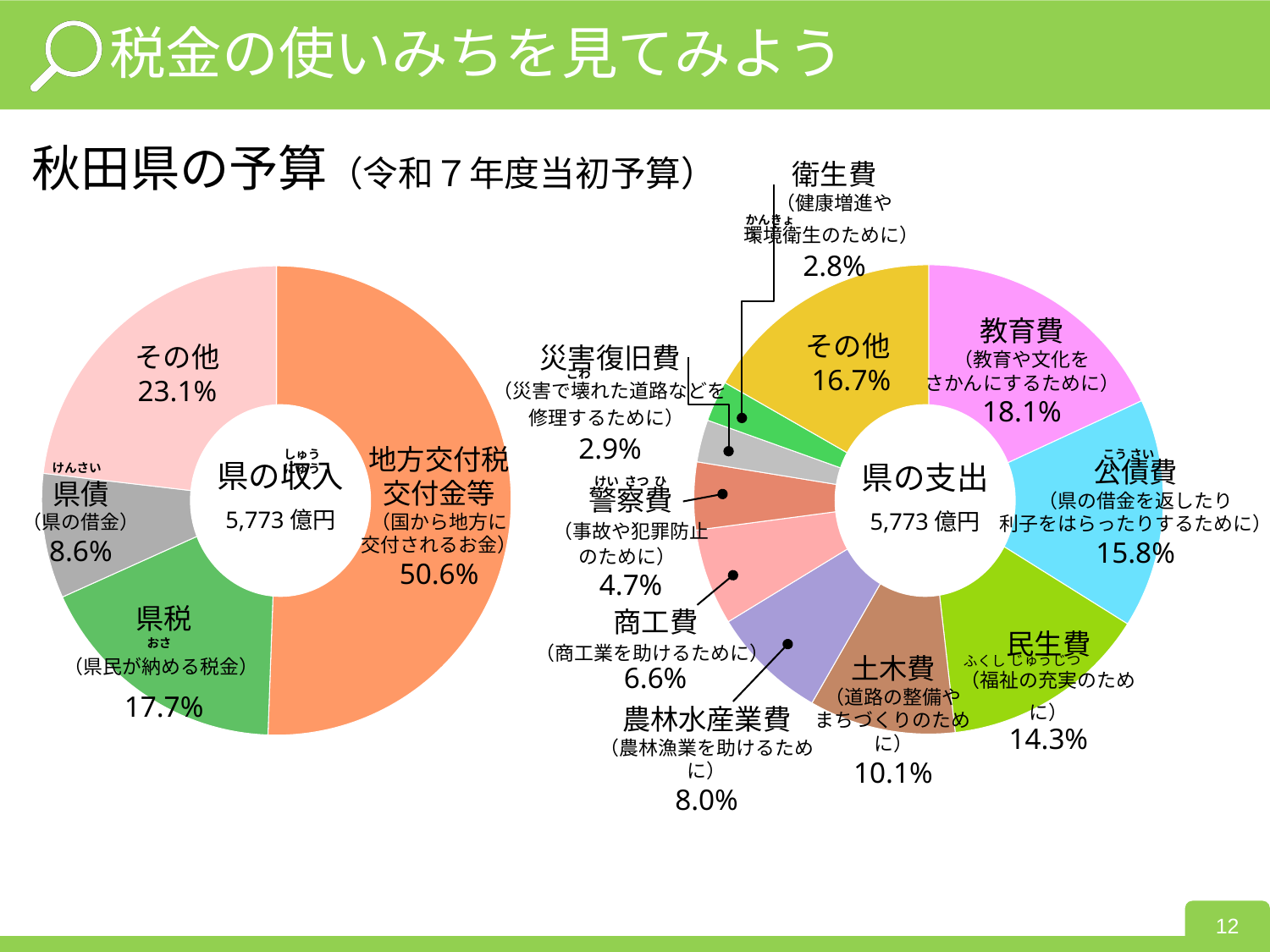
「県の収入」のグラフで、地方交付税交付金等の割合は何%ですか？ 50.6% 「県の収入」のグラフには、いくつの項目がありますか？ 4 「県の支出」のグラフで、最も割合が小さい項目はどれですか？ 衛生費 「県の支出」のグラフには、いくつの項目がありますか？ 10 「県の支出」のグラフで、最も割合が大きい項目はどれですか？ 教育費 「県の収入」のグラフの中央に示されている合計金額はいくらですか？ 5,773 億円 「県の支出」のグラフで、教育費の割合は何%ですか？ 18.1% このスライドの2つのグラフはどのような種類のグラフですか？ 円グラフ（ドーナツグラフ） 「県の支出」のグラフで、土木費と農林水産業費の割合の差は何ポイントですか？ 2.1ポイント 「県の支出」のグラフで、公債費と民生費ではどちらの割合が大きいですか？ 公債費 「県の収入」のグラフで、最も割合が小さい項目はどれですか？ 県債 「県の収入」のグラフで、その他と県税の割合の差は何ポイントですか？ 5.4ポイント